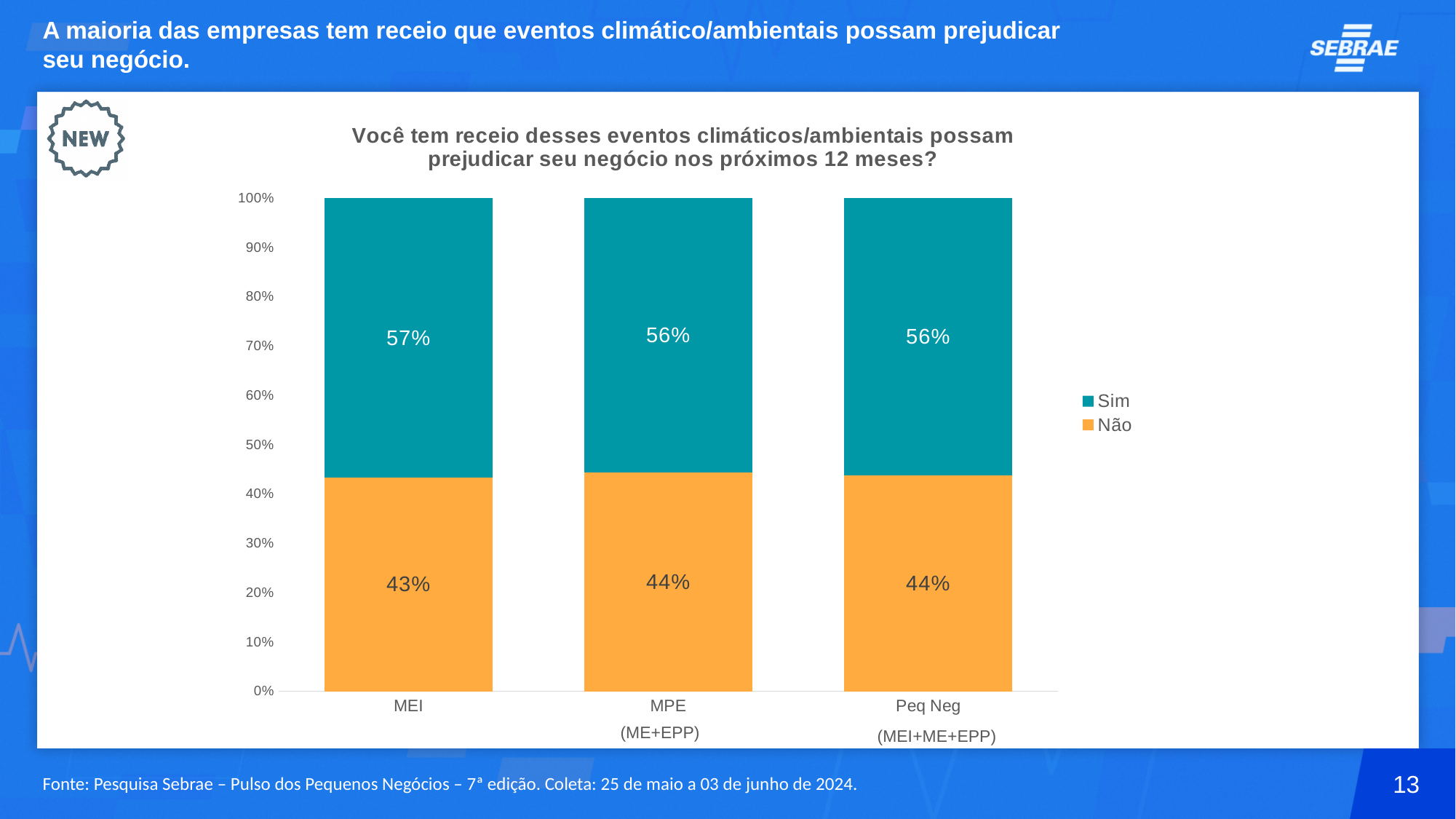
What kind of chart is shown on the slide? Stacked bar chart What is the value for "Sim" for Peq Neg (MEI+ME+EPP)? 56% What is the value for "Sim" for MEI? 57% For MPE (ME+EPP), which is larger: "Sim" or "Não"? Sim How many categories are shown on the x axis? 3 What is the total of the stacked bar for Peq Neg (MEI+ME+EPP)? 100% What is the value for "Não" for MEI? 43% Which category has the highest "Sim" value? MEI What is the value for "Não" for MPE (ME+EPP)? 44% Which category has the lowest "Não" value? MEI What is the difference between the "Sim" and "Não" values for MEI? 14% How many series does the legend list? 2